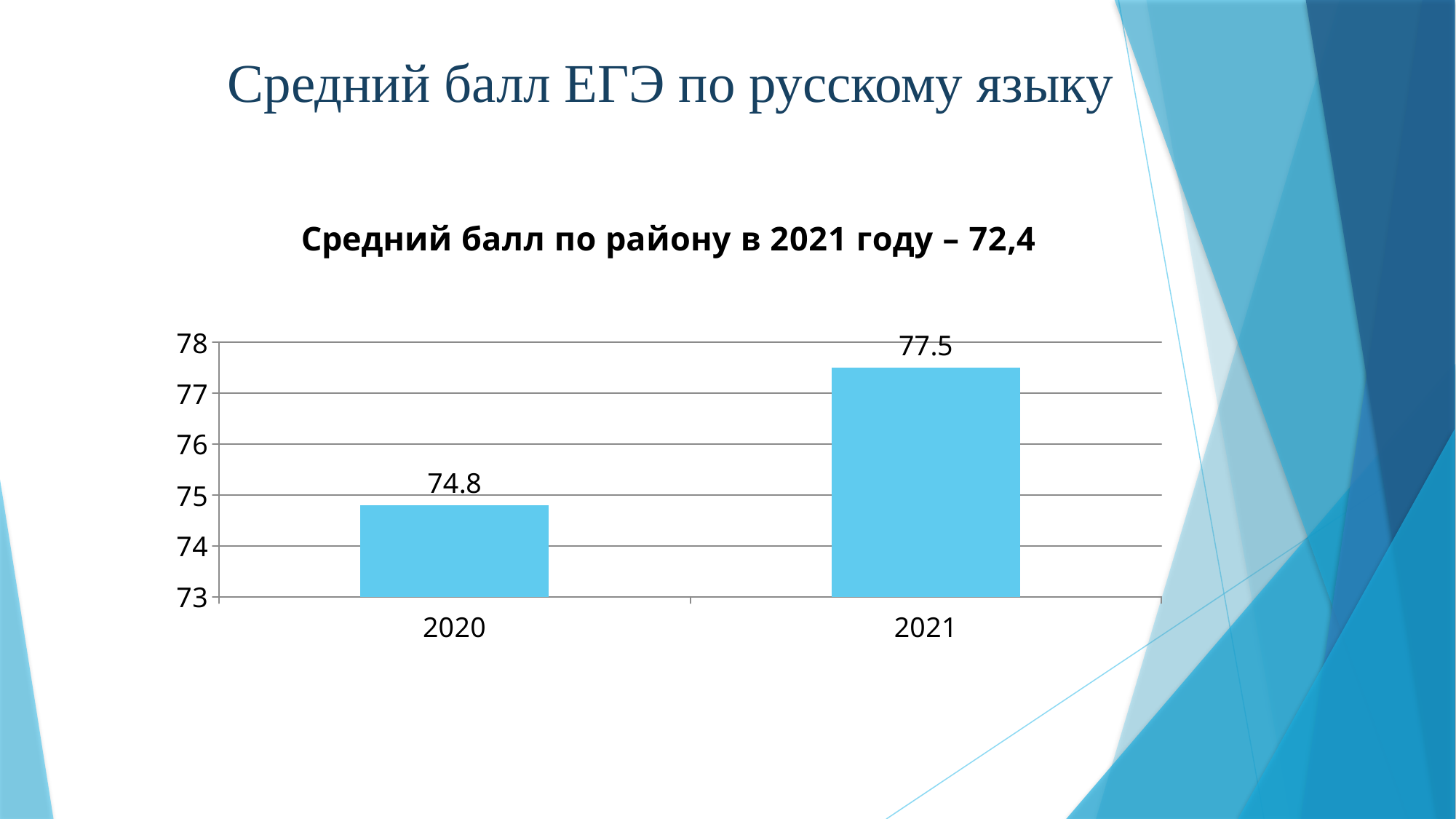
Which year has the highest value? 2021 Is the value for 2021 greater or less than 77? greater Do the values rise or fall from 2020 to 2021? rise What is the difference between the values for 2021 and 2020? 2.7 What kind of chart is shown on the slide? bar chart How many categories are shown on the x axis? 2 What is the value for 2020? 74.8 What is the value for 2021? 77.5 Which year has the lowest value? 2020 Is the value for 2020 greater or less than 75? less What is the title of the chart? Средний балл по району в 2021 году – 72,4 Which is larger, the value for 2020 or the value for 2021? 2021